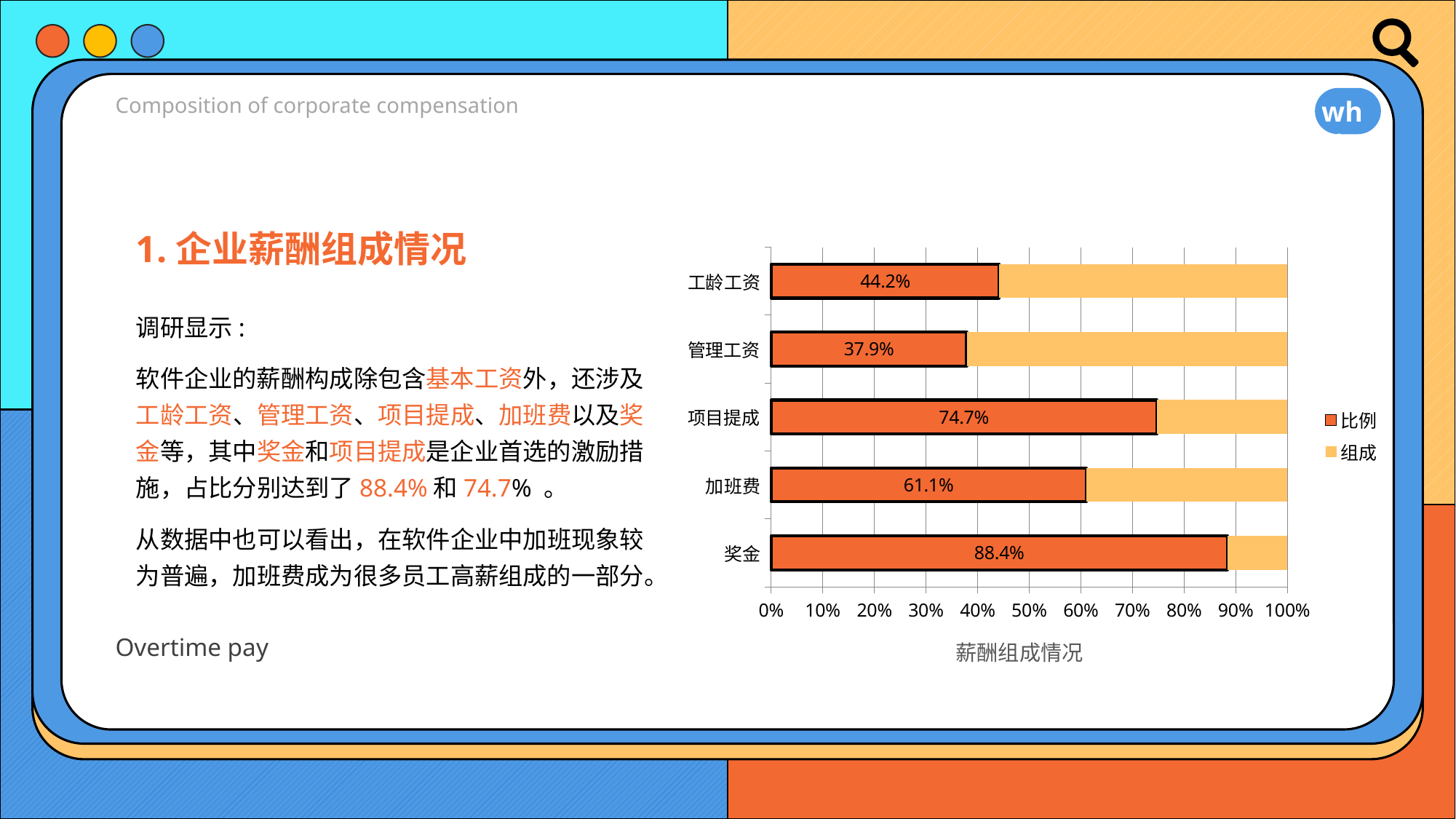
What is the difference between the 比例 values for 奖金 and 项目提成? 13.7% How many categories are shown on the chart? 5 What type of chart is shown on the slide? bar chart Which has a larger 比例 value, 加班费 or 工龄工资? 加班费 Is the 比例 value for 项目提成 greater or less than 70%? greater What is the 比例 value for 奖金? 88.4% What is the 比例 value for 工龄工资? 44.2% Which category has the lowest 比例 value? 管理工资 How many series does the legend list? 2 What is the 比例 value for 管理工资? 37.9% Which category has the highest 比例 value? 奖金 What is the 比例 value for 加班费? 61.1%